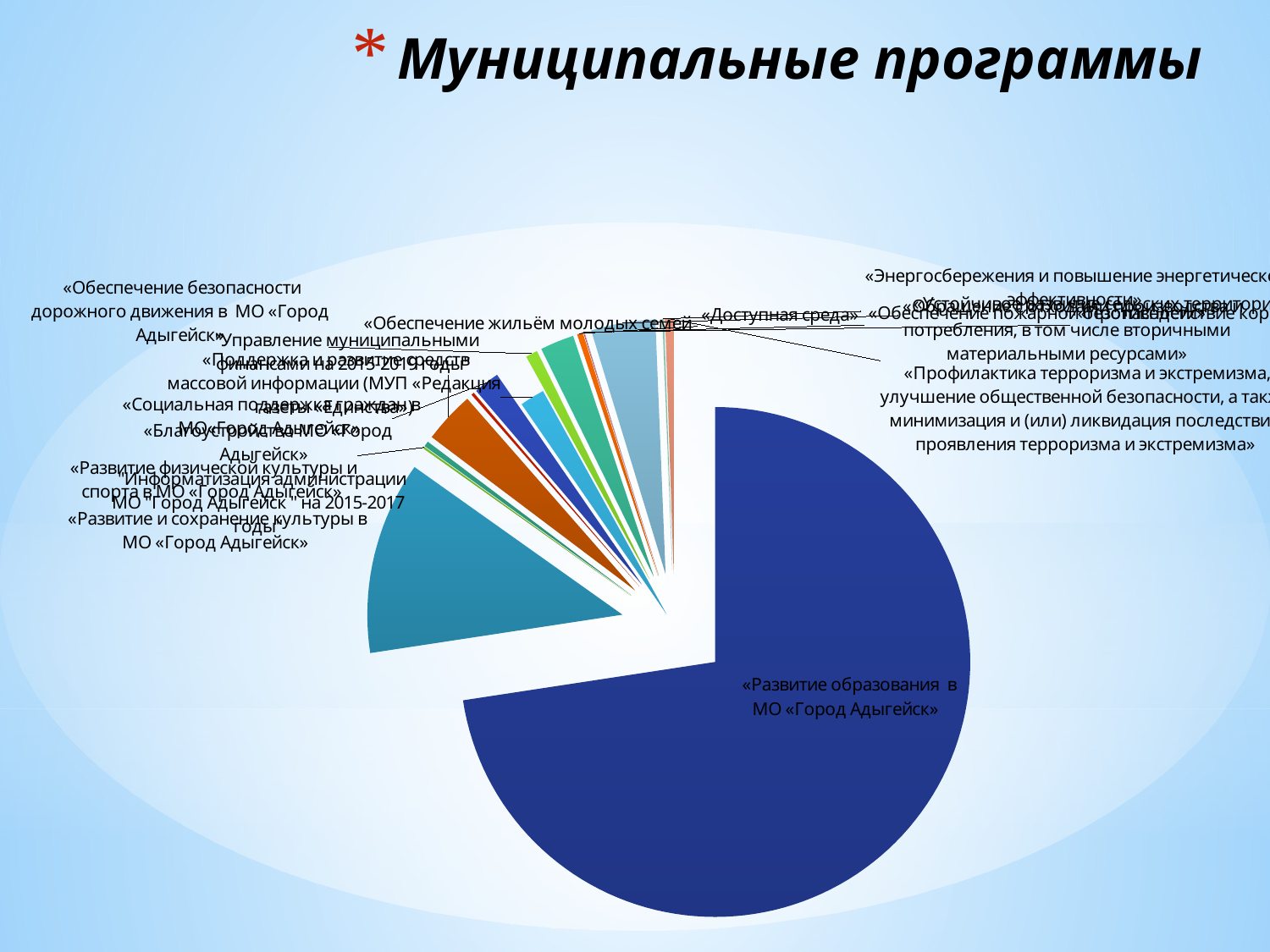
Which programme has the largest slice of the pie chart? «Развитие образования в МО «Город Адыгейск» What kind of chart is shown on the slide? pie chart What is the title of the slide containing the chart? Муниципальные программы Which slice is larger: «Развитие образования в МО «Город Адыгейск» or «Обеспечение жильём молодых семей»? «Развитие образования в МО «Город Адыгейск» Which slice is larger: «Доступная среда» or «Развитие образования в МО «Город Адыгейск»? «Развитие образования в МО «Город Адыгейск» What colour is the largest slice of the pie chart? dark blue Does the slice for «Развитие образования в МО «Город Адыгейск» take up more or less than half of the pie? more